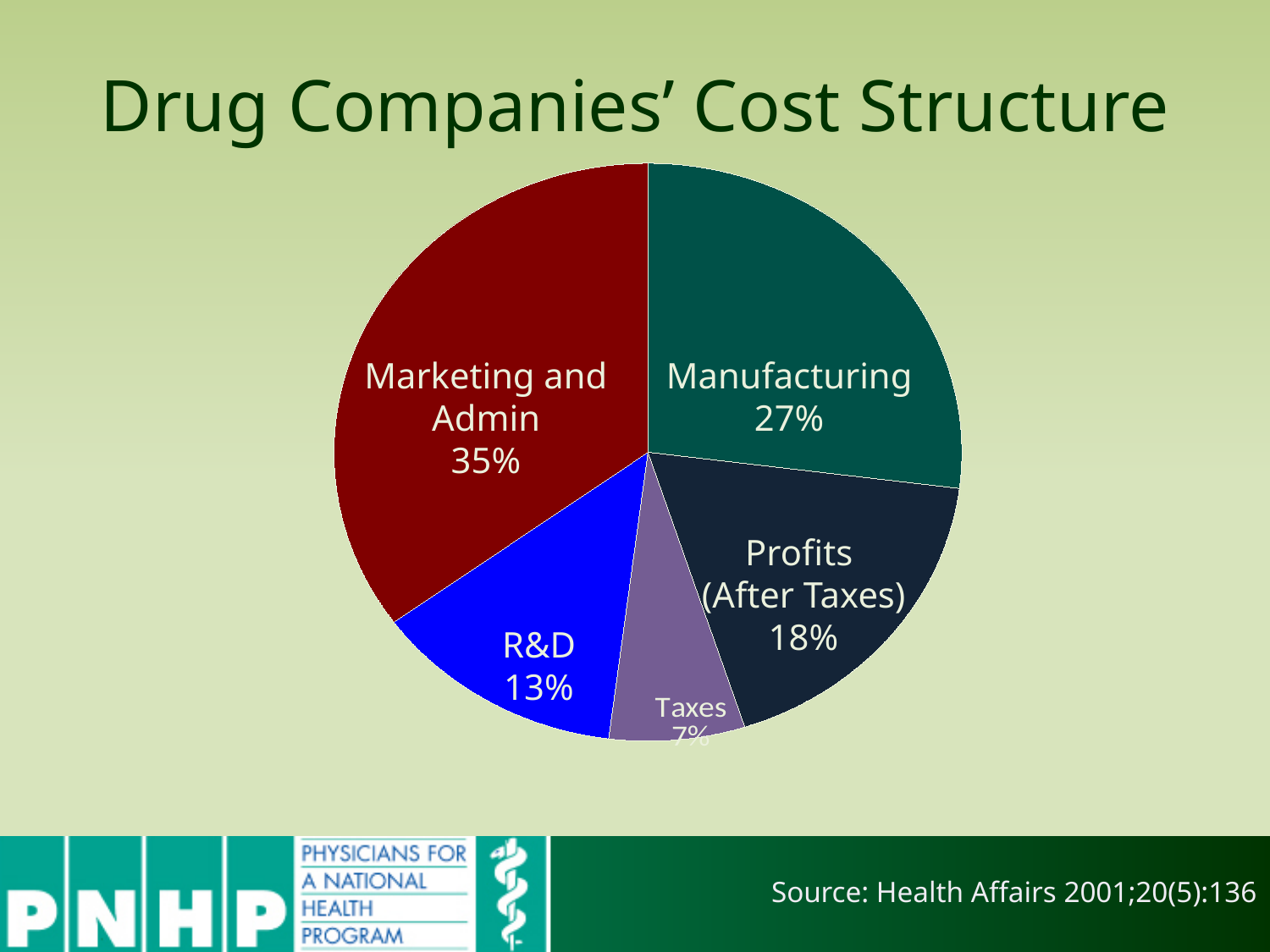
How many slices does the pie chart have? 5 What share of the pie is Marketing and Admin? 35% Which category has the largest slice of the pie? Marketing and Admin What share of the pie is Profits (After Taxes)? 18% What colour is the R&D slice? blue Which category has the smallest slice of the pie? Taxes Which is larger, Manufacturing or Profits (After Taxes)? Manufacturing What kind of chart is shown on the slide? pie chart What is the difference in percentage points between Marketing and Admin and R&D? 22 What share of the pie is Manufacturing? 27% What is the title of the chart? Drug Companies' Cost Structure What share of the pie is R&D? 13%